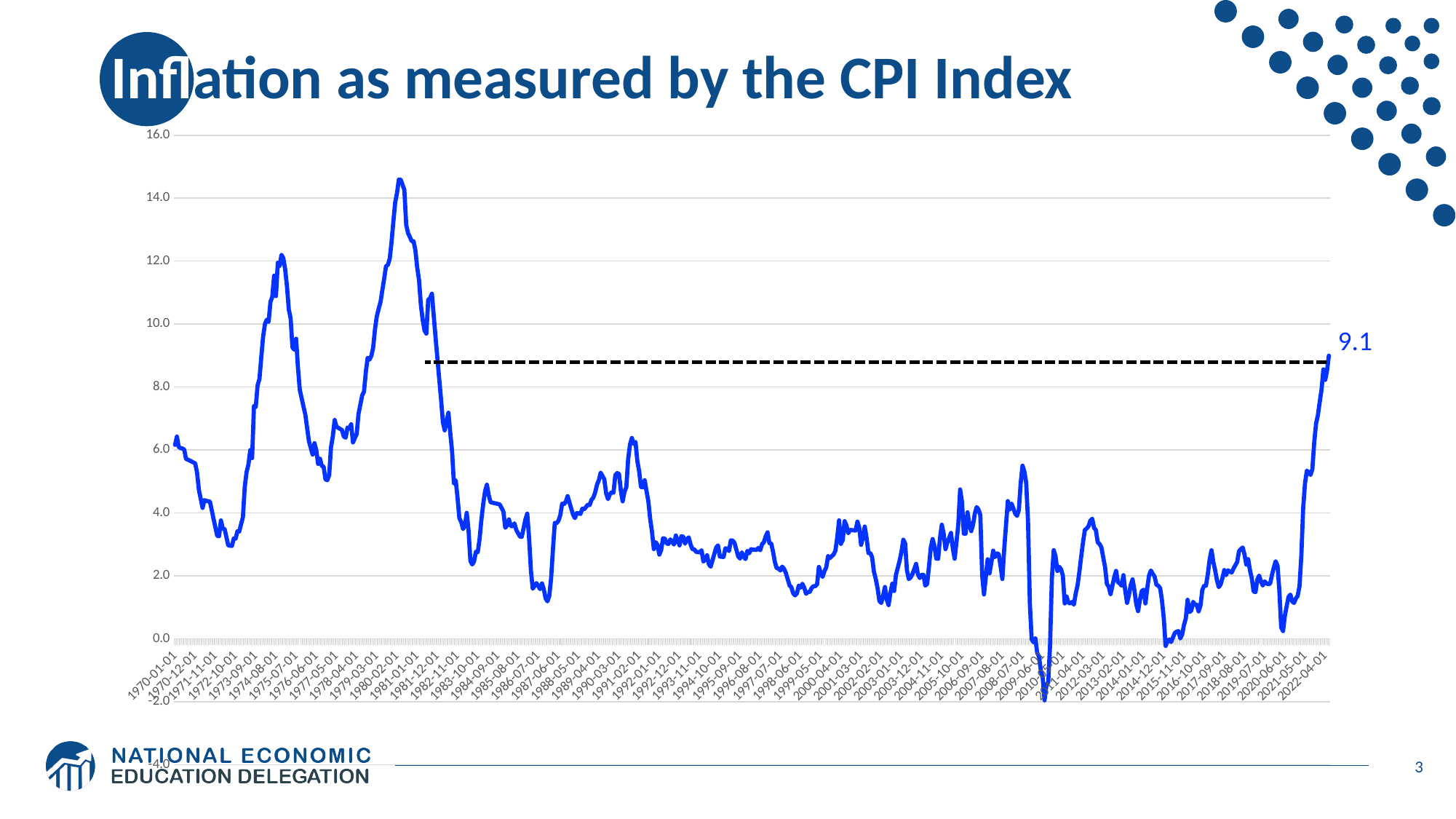
What colour is the plotted line? blue What kind of chart is shown on the slide? line chart Is the value at the start of the series, 1970-01-01, greater or less than 8.0? less Is the lowest point of the line, around 2009, greater or less than 0.0? less Is the peak of the line around 1980 greater or less than 14.0? greater What value is labelled at the right end of the line, for 2022? 9.1 Which is higher: the peak around 1980 or the peak around 1974-1975? the peak around 1980 Does the line rise or fall between 2020 and 2022? rise Which is higher: the value at 2022-04-01 or the peak around 1990-1991? the value at 2022-04-01 In which period does the line reach its highest value? around 1980 What is the title of the chart? Inflation as measured by the CPI Index